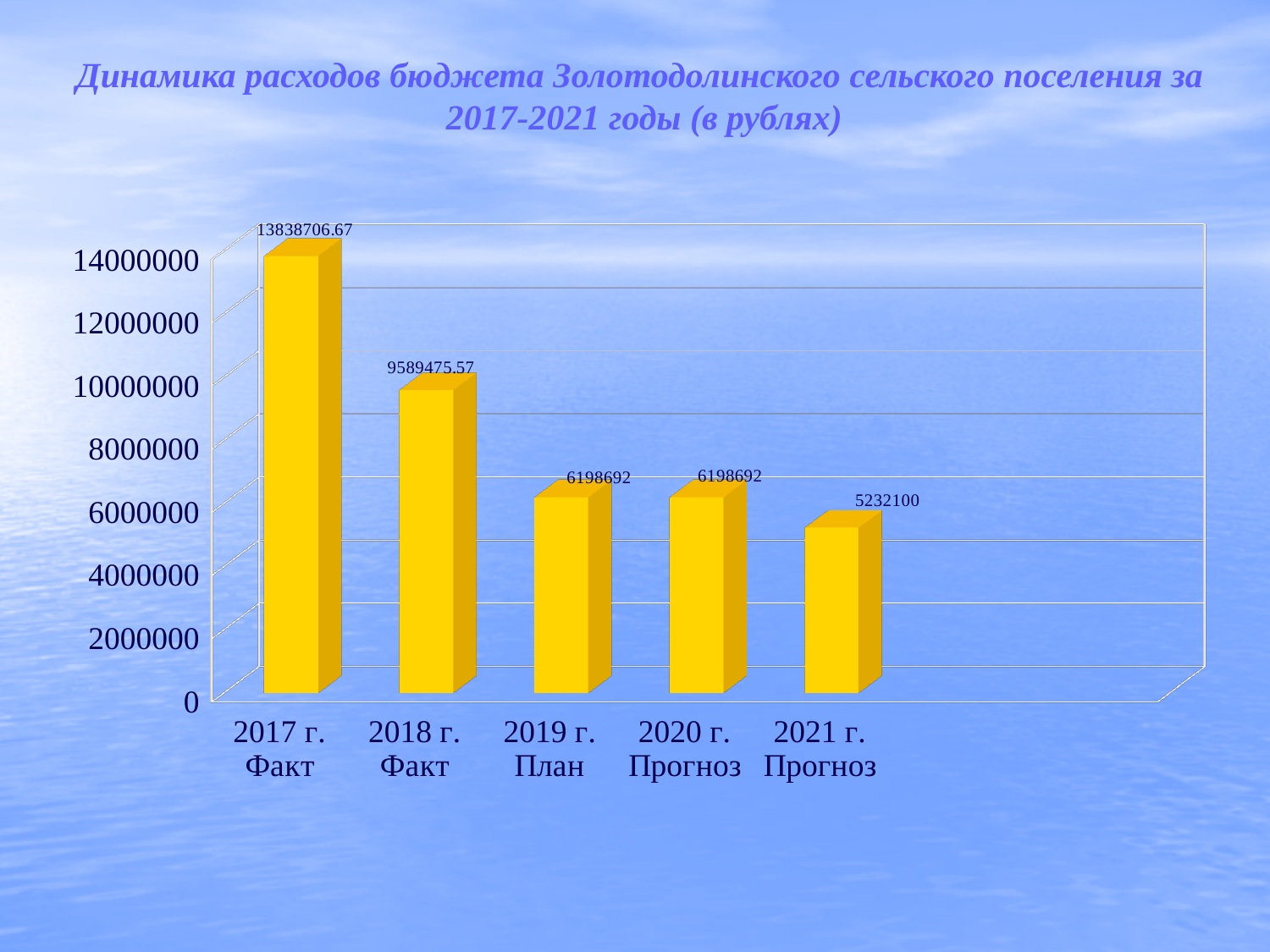
Which category has the lowest value? 2021 г. Прогноз What is the value for 2017 г. Факт? 13838706.67 What is the value for 2018 г. Факт? 9589475.57 What is the value for 2021 г. Прогноз? 5232100 Which category has the highest value? 2017 г. Факт What is the difference between the values for 2020 г. Прогноз and 2021 г. Прогноз? 966592 How many categories are shown on the x axis? 5 What kind of chart is shown on the slide? bar chart Which is larger, the value for 2018 г. Факт or the value for 2019 г. План? 2018 г. Факт Do the values generally rise or fall from 2017 to 2021? fall What is the difference between the values for 2017 г. Факт and 2018 г. Факт? 4249231.10 What is the value for 2019 г. План? 6198692